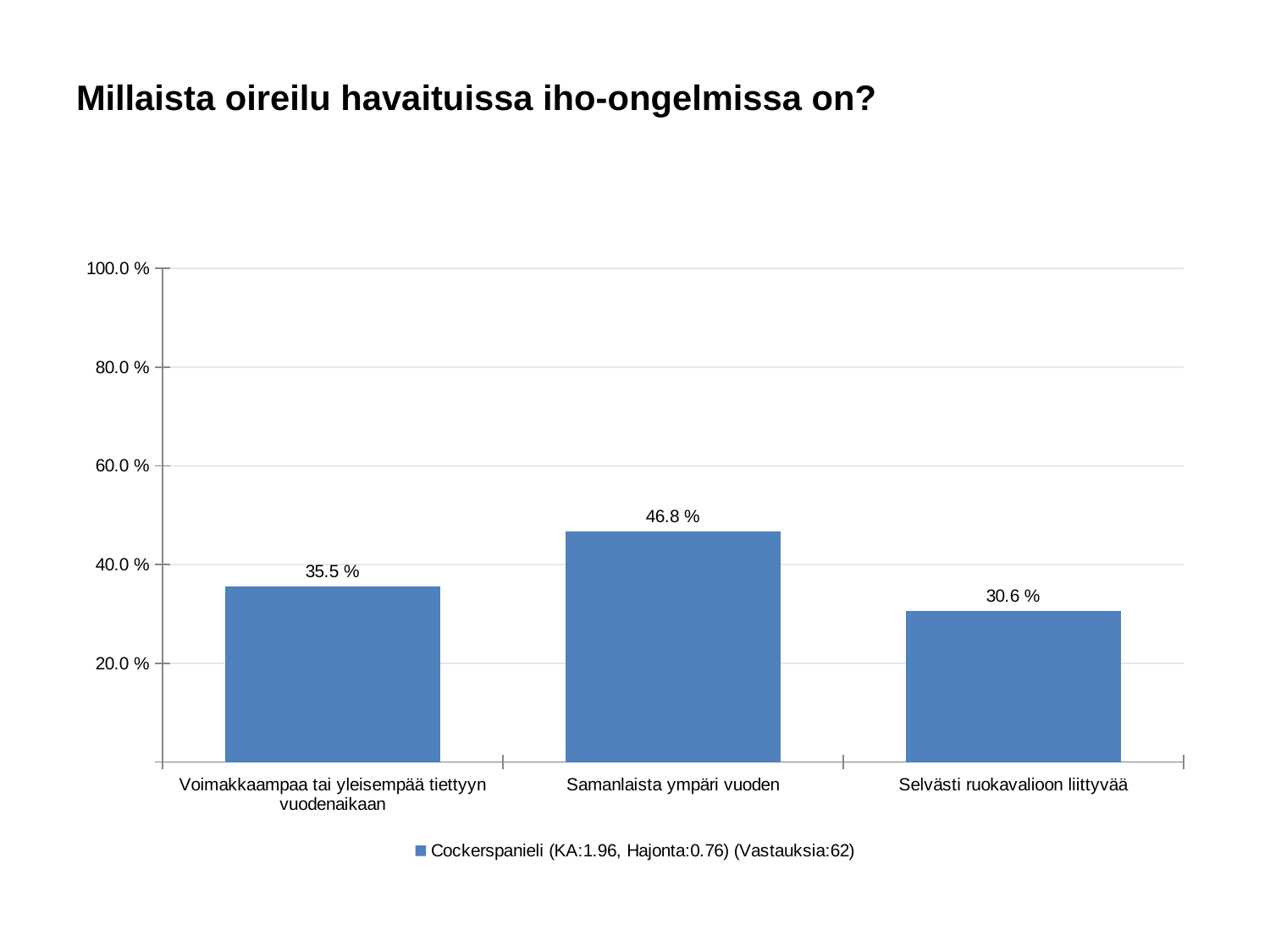
Is the value for "Samanlaista ympäri vuoden" greater or less than 40.0 %? greater Which category has the highest value? Samanlaista ympäri vuoden What kind of chart is shown on the slide? bar chart What is the value for "Samanlaista ympäri vuoden"? 46.8 % What is the legend entry for the series shown? Cockerspanieli (KA:1.96, Hajonta:0.76) (Vastauksia:62) Which category has the lowest value? Selvästi ruokavalioon liittyvää What is the difference between the values for "Voimakkaampaa tai yleisempää tiettyyn vuodenaikaan" and "Selvästi ruokavalioon liittyvää"? 4.9 % What is the value for "Voimakkaampaa tai yleisempää tiettyyn vuodenaikaan"? 35.5 % What is the difference between the values for "Samanlaista ympäri vuoden" and "Selvästi ruokavalioon liittyvää"? 16.2 % What is the value for "Selvästi ruokavalioon liittyvää"? 30.6 % How many categories are shown on the x axis? 3 Which is larger: the value for "Voimakkaampaa tai yleisempää tiettyyn vuodenaikaan" or for "Samanlaista ympäri vuoden"? Samanlaista ympäri vuoden